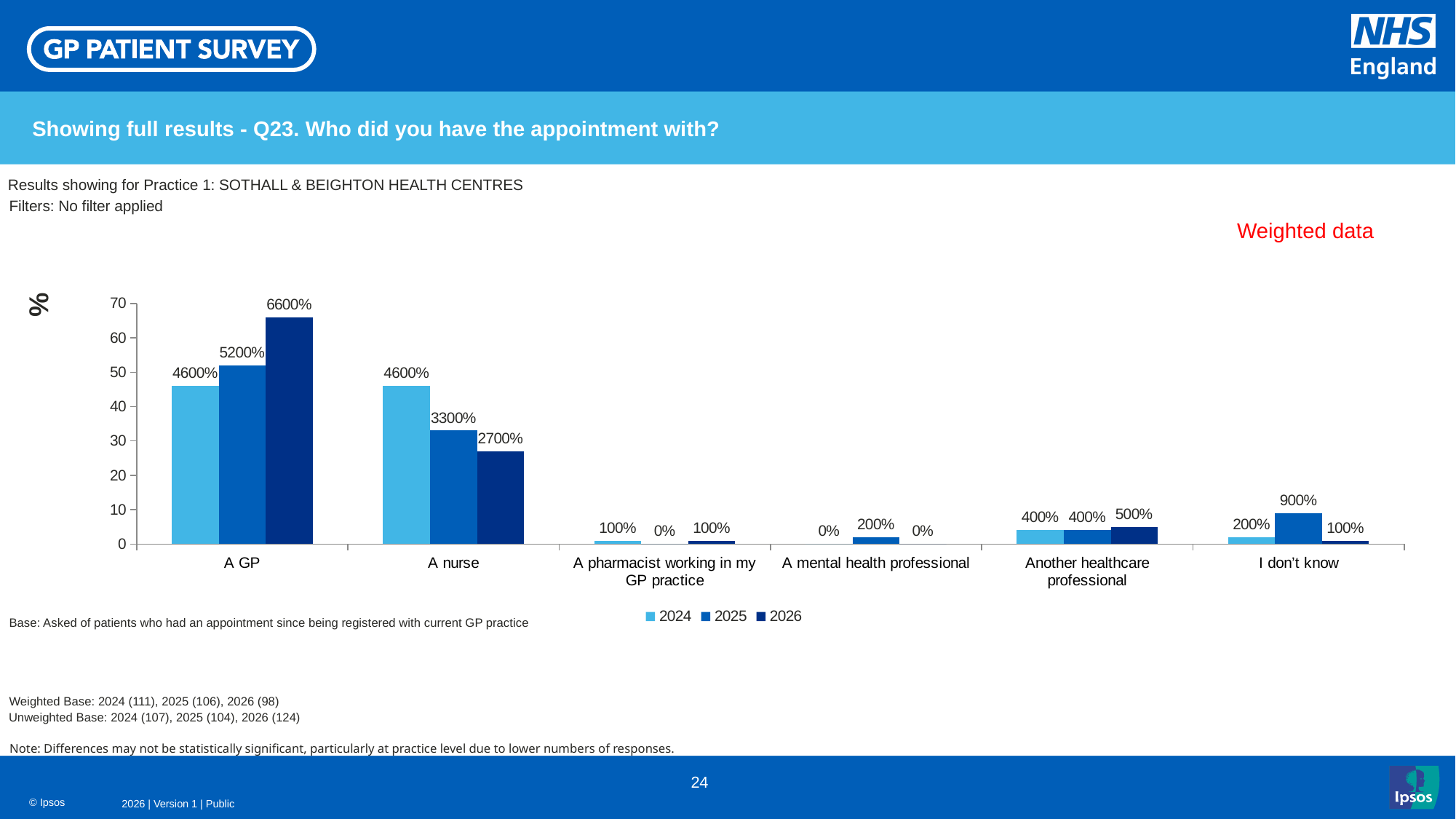
For 'A nurse', which series has the larger value, 2024 or 2026? 2024 Which category has the highest value in the 2026 series? A GP What is the data label for 'Another healthcare professional' in the 2026 series? 500% What kind of chart is shown on the slide? Bar chart What is the data label for 'A nurse' in the 2025 series? 3300% Which category has the lowest value in the 2025 series? A pharmacist working in my GP practice What is the data label for 'I don't know' in the 2025 series? 900% What is the data label for 'A GP' in the 2026 series? 6600% How many series does the legend list? 3 What is the difference between the 2026 and 2024 data labels for 'A GP'? 2000% How many categories are shown on the x axis? 6 For 'A nurse', do the values rise or fall from 2024 to 2026? Fall